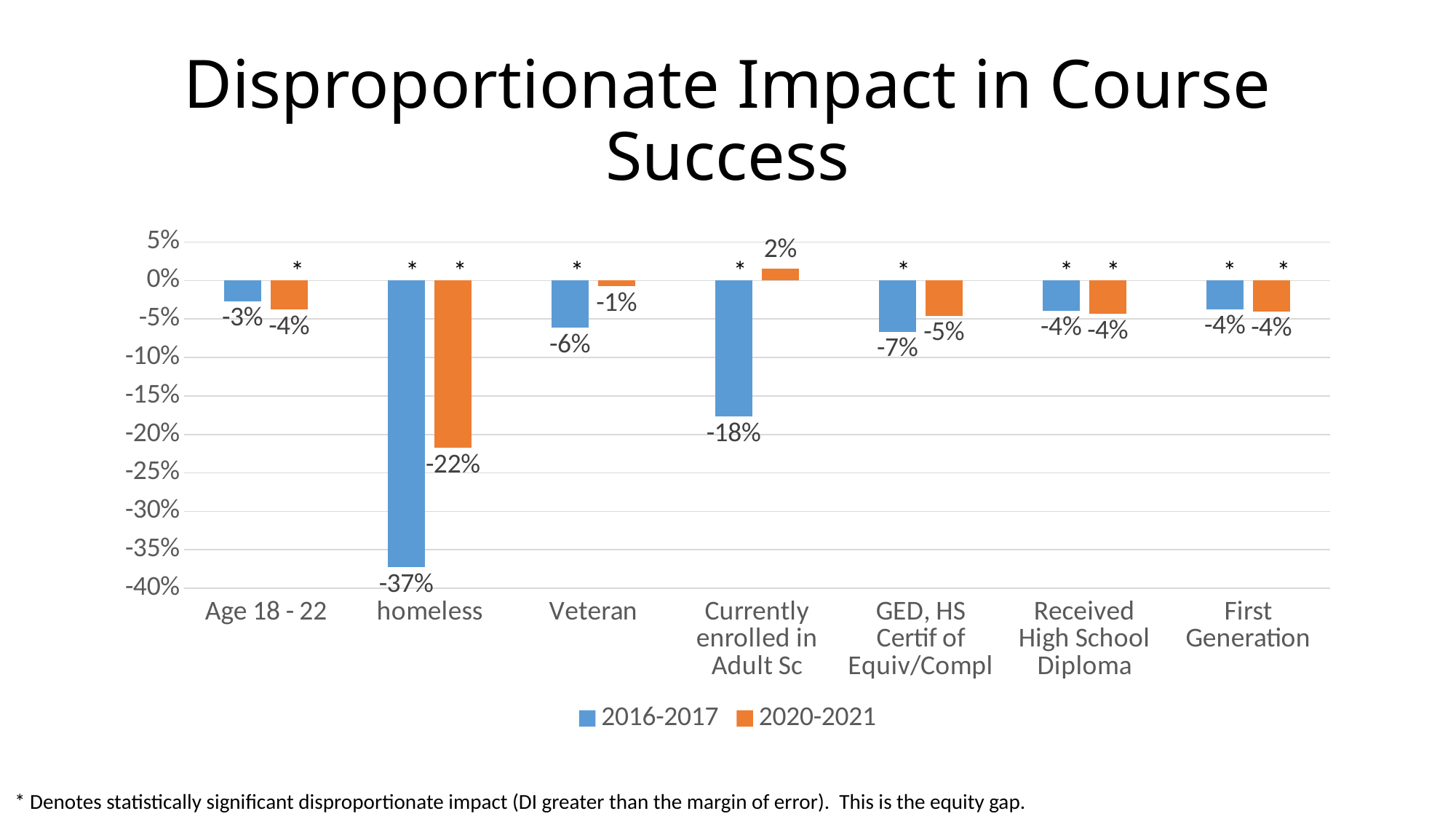
How many series does the legend list? 2 Which category has the highest 2020-2021 value? Currently enrolled in Adult Sc Which is larger for Age 18 - 22, the 2016-2017 value or the 2020-2021 value? 2016-2017 What is the title of the chart? Disproportionate Impact in Course Success What is the 2020-2021 value for GED, HS Certif of Equiv/Compl? -5% What is the 2016-2017 value for homeless? -37% What is the difference between the 2016-2017 and 2020-2021 values for homeless? 15 percentage points Which category has the lowest 2016-2017 value? homeless What kind of chart is shown on the slide? Bar chart How many categories are shown on the x axis? 7 What is the 2020-2021 value for Currently enrolled in Adult Sc? 2% What is the 2016-2017 value for Veteran? -6%